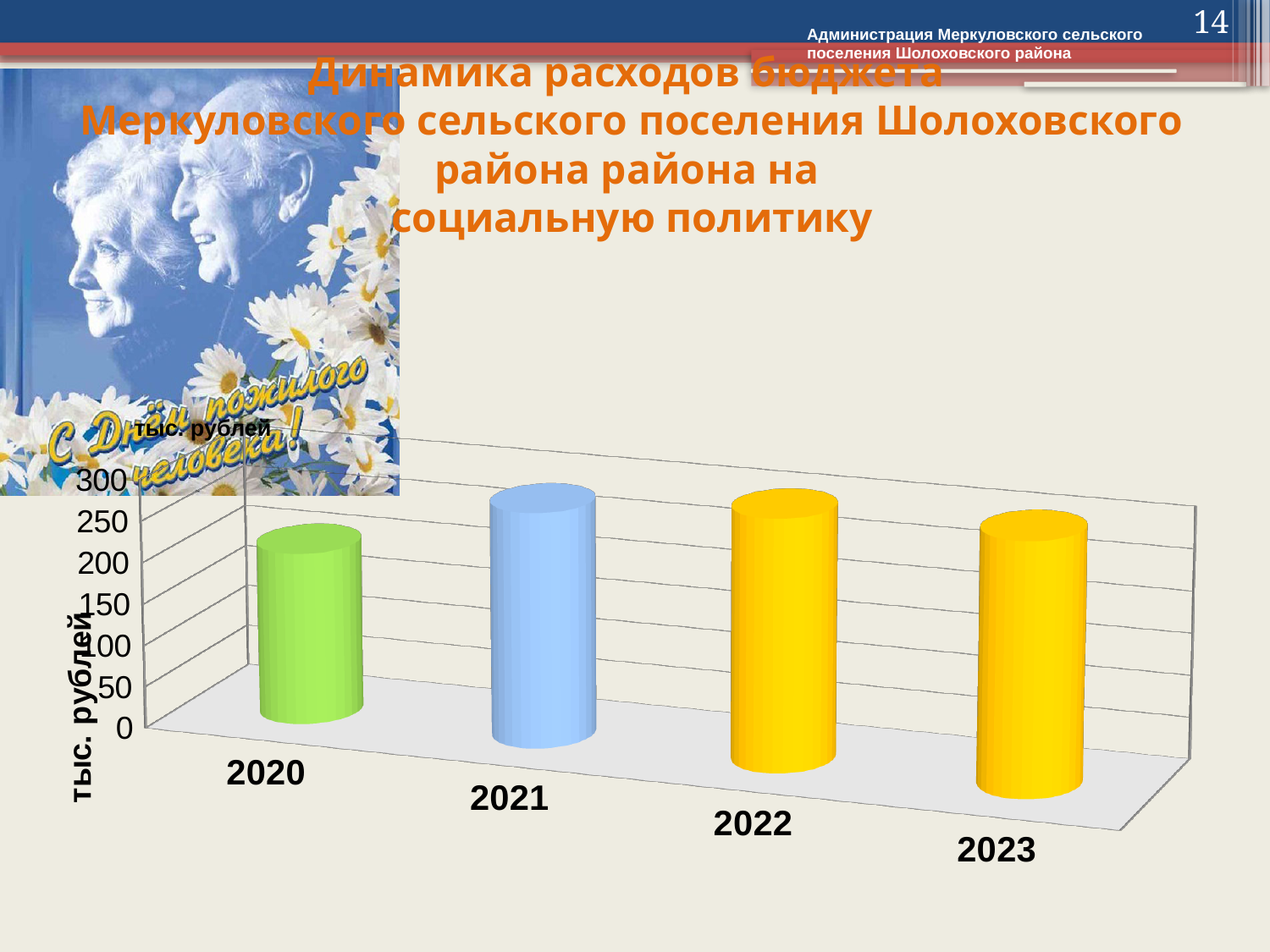
What kind of chart is shown on the slide? bar chart Is the value for 2020 greater or less than 300? less Which is larger, the value for 2020 or the value for 2023? 2023 Is the value for 2021 greater or less than 50? greater What is the first year shown on the x axis of the chart? 2020 Is the value for 2020 greater or less than 150? greater How many years are shown on the x axis of the chart? 4 What unit is given on the vertical axis of the chart? тыс. рублей Which year has the lowest value in the chart? 2020 Which is larger, the value for 2020 or the value for 2021? 2021